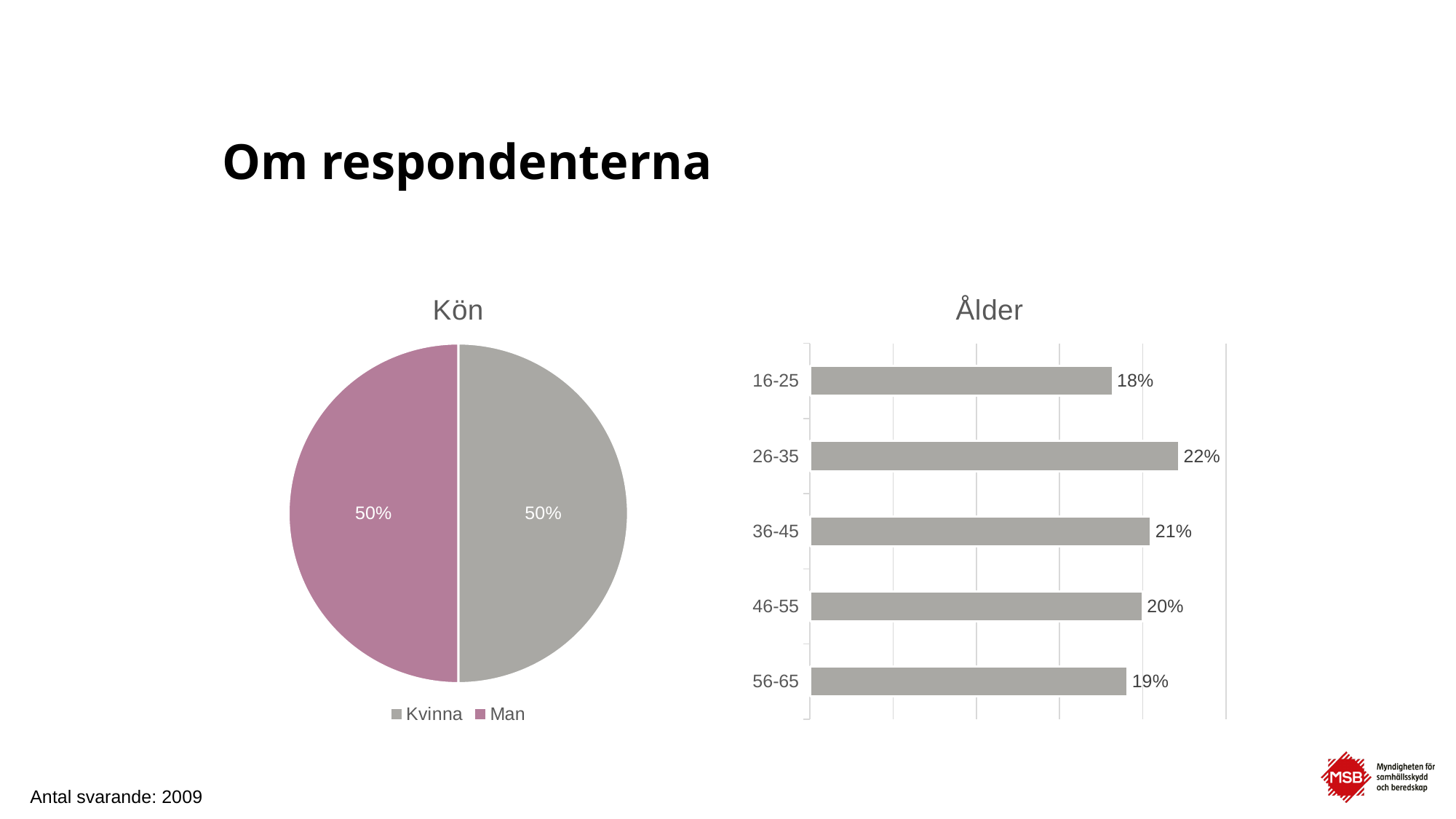
In the 'Ålder' chart, which is larger, the value for 36-45 or the value for 46-55? 36-45 What kind of chart is the 'Kön' chart? pie chart In the 'Ålder' chart, what is the difference between the values for 26-35 and 16-25? 4% In the 'Kön' chart, what share of respondents are Man? 50% In the 'Ålder' chart, which age group has the highest value? 26-35 What kind of chart is the 'Ålder' chart? bar chart How many entries does the legend of the 'Kön' chart list? 2 In the 'Ålder' chart, what is the value for 56-65? 19% How many age groups are shown in the 'Ålder' chart? 5 In the 'Kön' chart, what share of respondents are Kvinna? 50% In the 'Ålder' chart, what is the value for 26-35? 22% In the 'Ålder' chart, which age group has the lowest value? 16-25